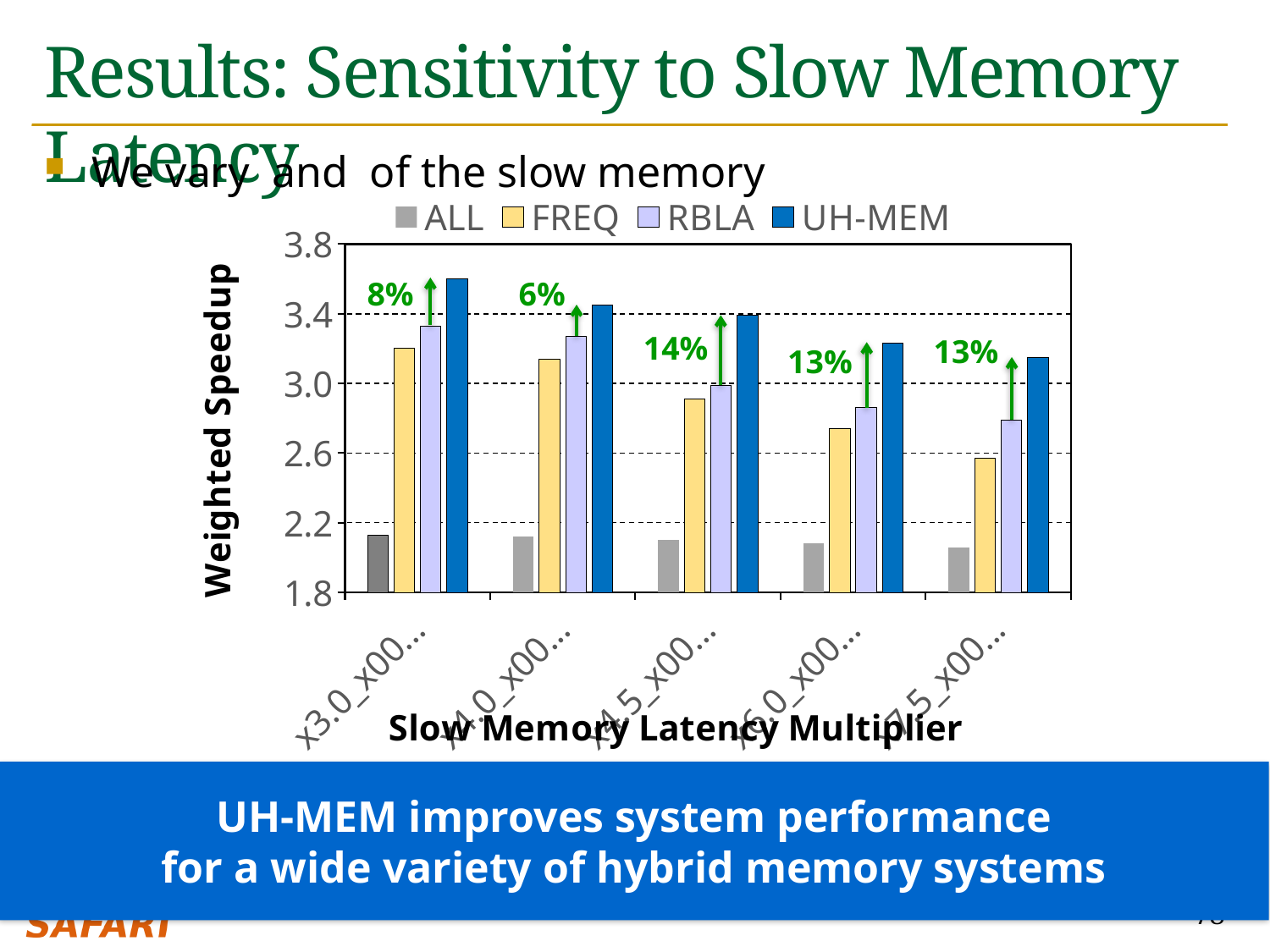
In the x4.5 category, which is larger, the UH-MEM bar or the RBLA bar? UH-MEM What is the title of the y axis? Weighted Speedup Which series has the tallest bar in every category group? UH-MEM What kind of chart is shown on the slide? bar chart Which series has the shortest bar in every category group? ALL Do the UH-MEM bars rise or fall as the slow memory latency multiplier increases along the x axis? fall How many series does the chart legend list? 4 What percentage improvement is annotated above the x4.5 category group? 14% How many slow memory latency multiplier categories are plotted on the x axis? 5 Is the UH-MEM value for the x3.0 category greater or less than 3.4? greater What is the title of the x axis? Slow Memory Latency Multiplier Is the RBLA value for the x7.5 category greater or less than 3.0? less